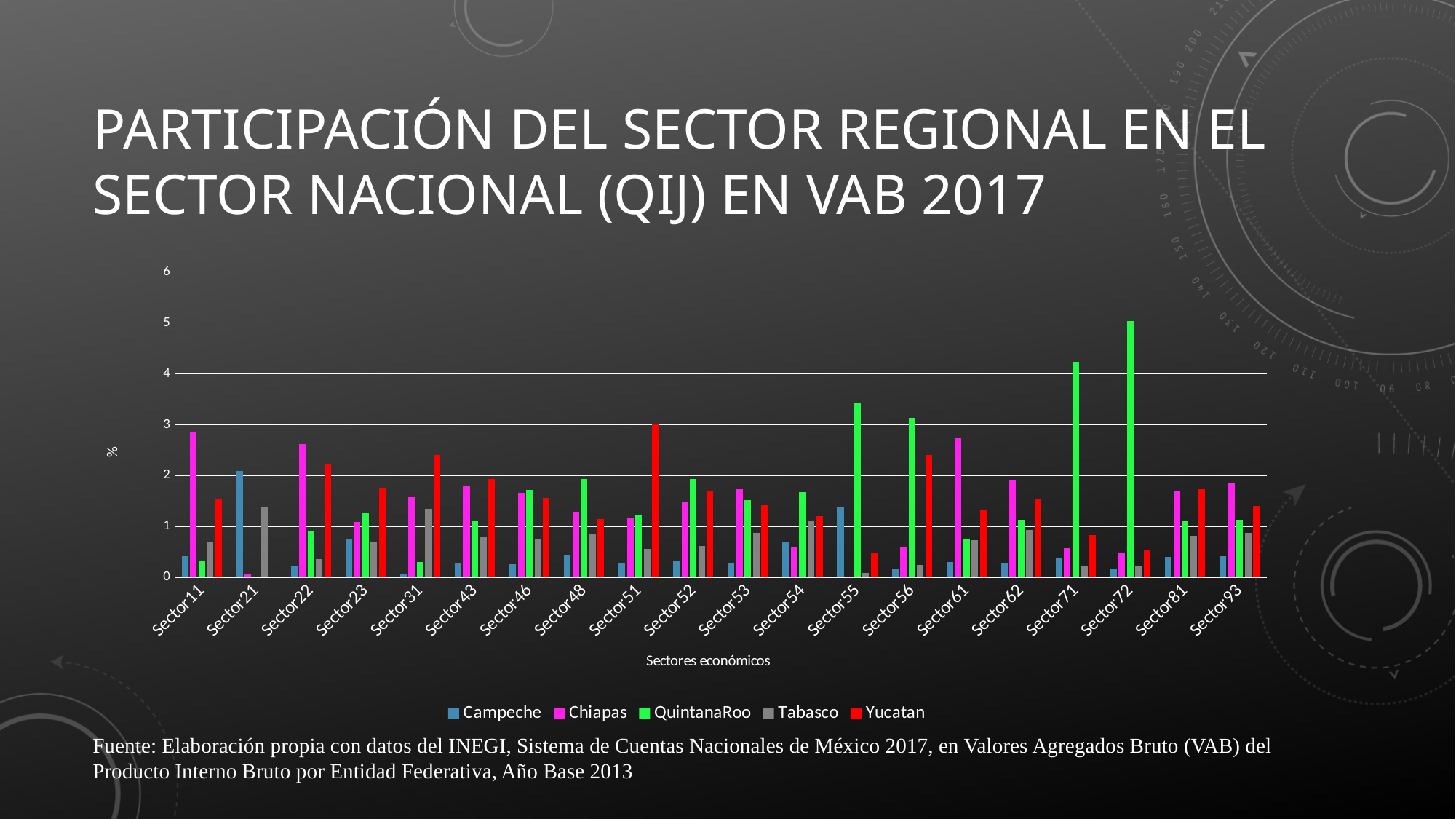
What kind of chart is shown on the slide? Bar chart In which sector does Yucatan reach its highest value? Sector51 What is the label on the x axis of the chart? Sectores económicos In which sector does Campeche reach its highest value? Sector21 How many series does the legend list? 5 Is the value for QuintanaRoo in Sector72 greater or less than 4? greater How many sectors are shown along the x axis? 20 Which state has the tallest bar in the whole chart? QuintanaRoo Is the value for Yucatan in Sector55 greater or less than 1? less Is the value for Chiapas in Sector11 greater or less than 2? greater In Sector55, which is larger: the value for QuintanaRoo or the value for Yucatan? QuintanaRoo